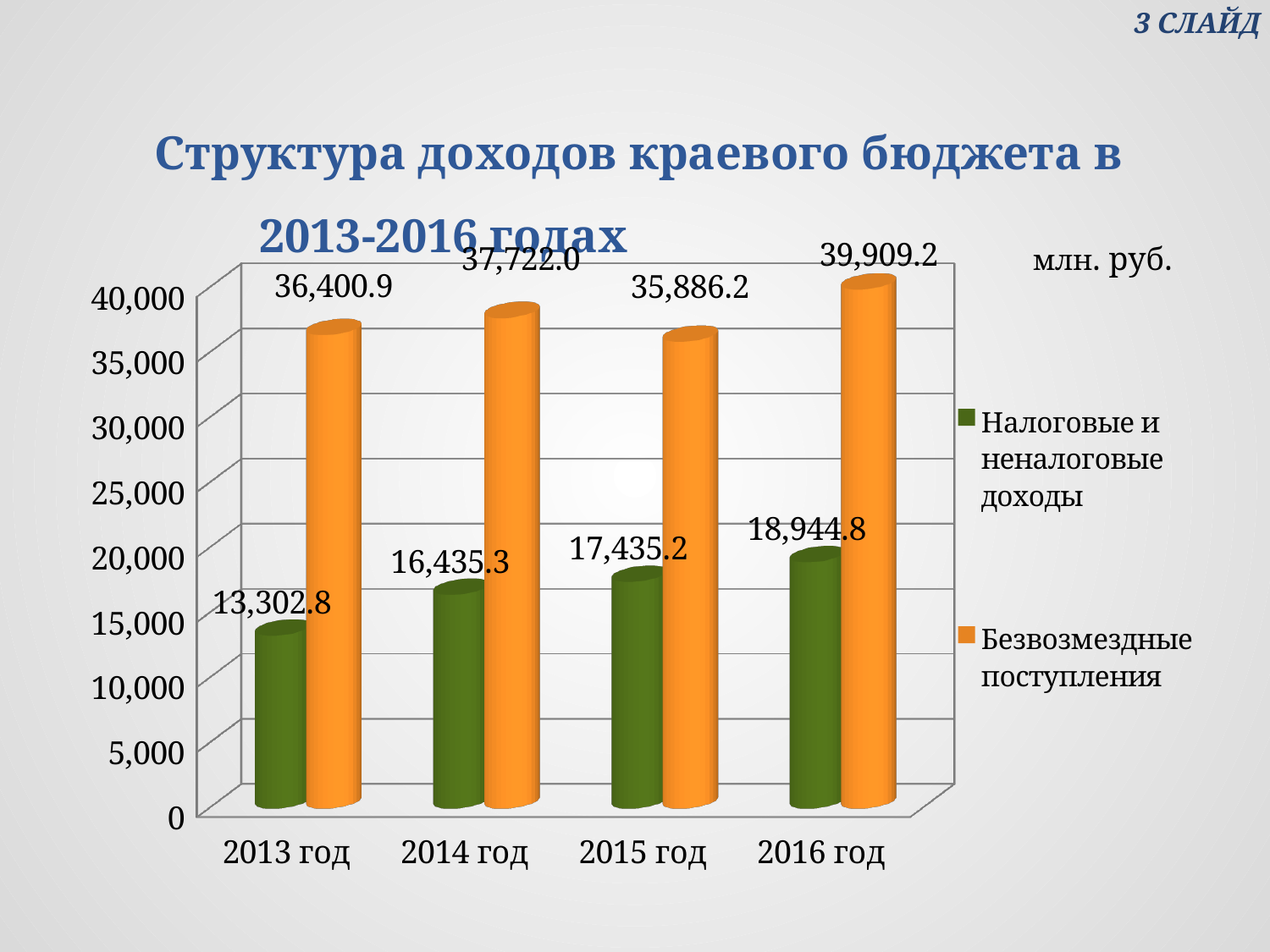
What is the value for Налоговые и неналоговые доходы in 2014 год? 16,435.3 How many years are shown on the x axis? 4 What is the value for Безвозмездные поступления in 2015 год? 35,886.2 In which year is Безвозмездные поступления highest? 2016 год What is the difference between Безвозмездные поступления and Налоговые и неналоговые доходы in 2016 год? 20,964.4 What is the value for Безвозмездные поступления in 2016 год? 39,909.2 In which year is Налоговые и неналоговые доходы lowest? 2013 год What is the value for Налоговые и неналоговые доходы in 2013 год? 13,302.8 How many series does the legend list? 2 Does Налоговые и неналоговые доходы rise or fall from 2013 год to 2016 год? rise By how much did Налоговые и неналоговые доходы grow from 2013 год to 2016 год? 5,642.0 Which is larger: Безвозмездные поступления in 2014 год or in 2015 год? 2014 год